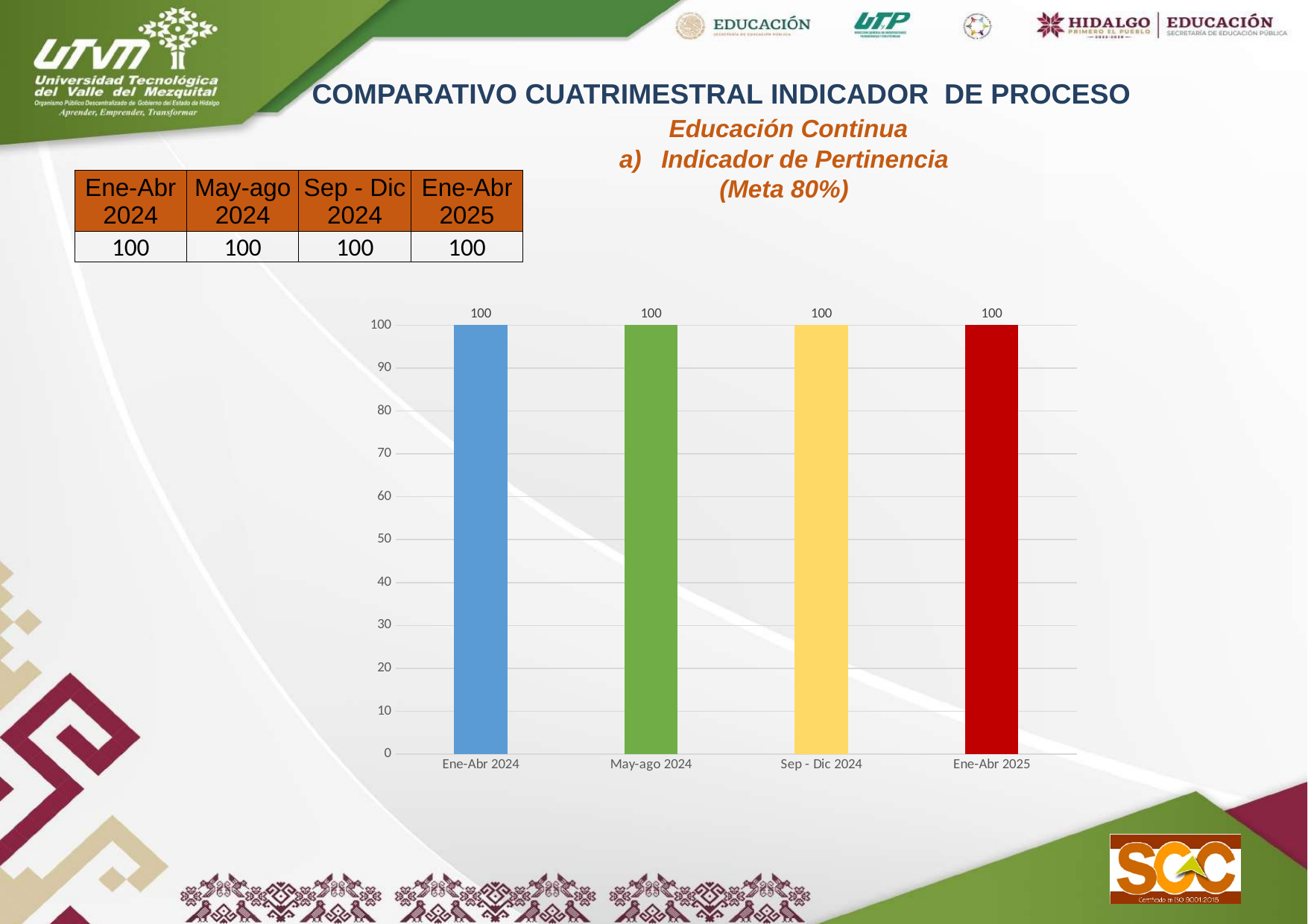
What is the difference between the values for Ene-Abr 2025 and Ene-Abr 2024? 0 What colour is the bar for Ene-Abr 2025? red Is the value for Sep - Dic 2024 greater or less than 80? greater What is the value for May-ago 2024 in the bar chart? 100 What is the value for Ene-Abr 2024 in the bar chart? 100 What is the value for Sep - Dic 2024 in the bar chart? 100 What is the highest value shown on the vertical axis of the chart? 100 How many categories are plotted in the bar chart? 4 Is the value for May-ago 2024 greater or less than 90? greater What kind of chart is shown on the slide? bar chart What is the value for Ene-Abr 2025 in the bar chart? 100 Do the values rise, fall or stay the same across the periods from Ene-Abr 2024 to Ene-Abr 2025? stay the same